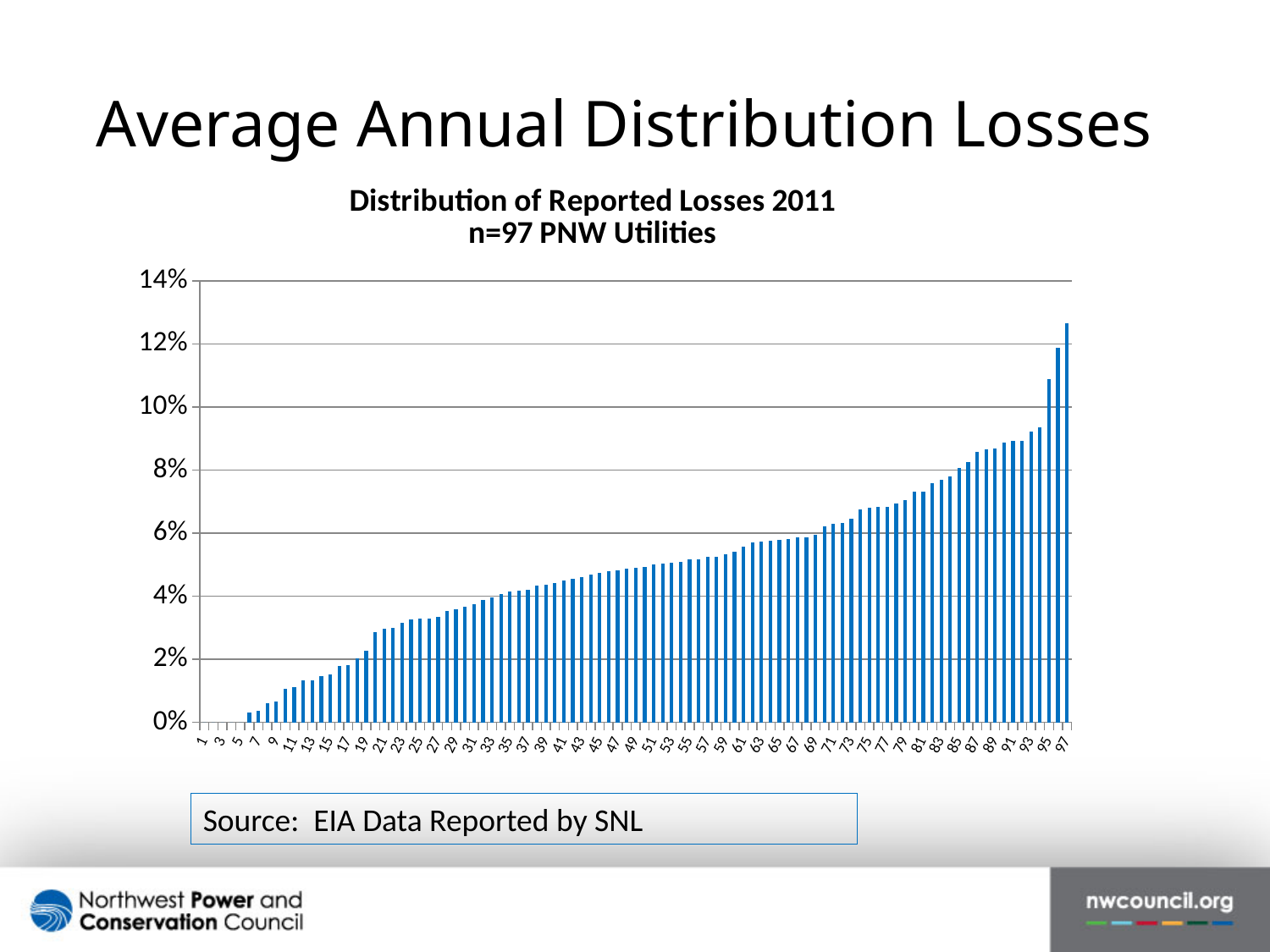
Is the value for utility 50 greater or less than 6%? less How many utilities are plotted in the chart? 97 Is the value for utility 90 greater or less than 8%? greater What is the title of the chart? Distribution of Reported Losses 2011 n=97 PNW Utilities Do the values rise or fall moving from left to right along the x axis? rise Is the value for utility 95 greater or less than 10%? greater Which utility number has the highest reported loss? 97 What is the highest tick shown on the y axis? 14% What kind of chart is shown on the slide? bar chart Which has the larger value, utility 40 or utility 80? 80